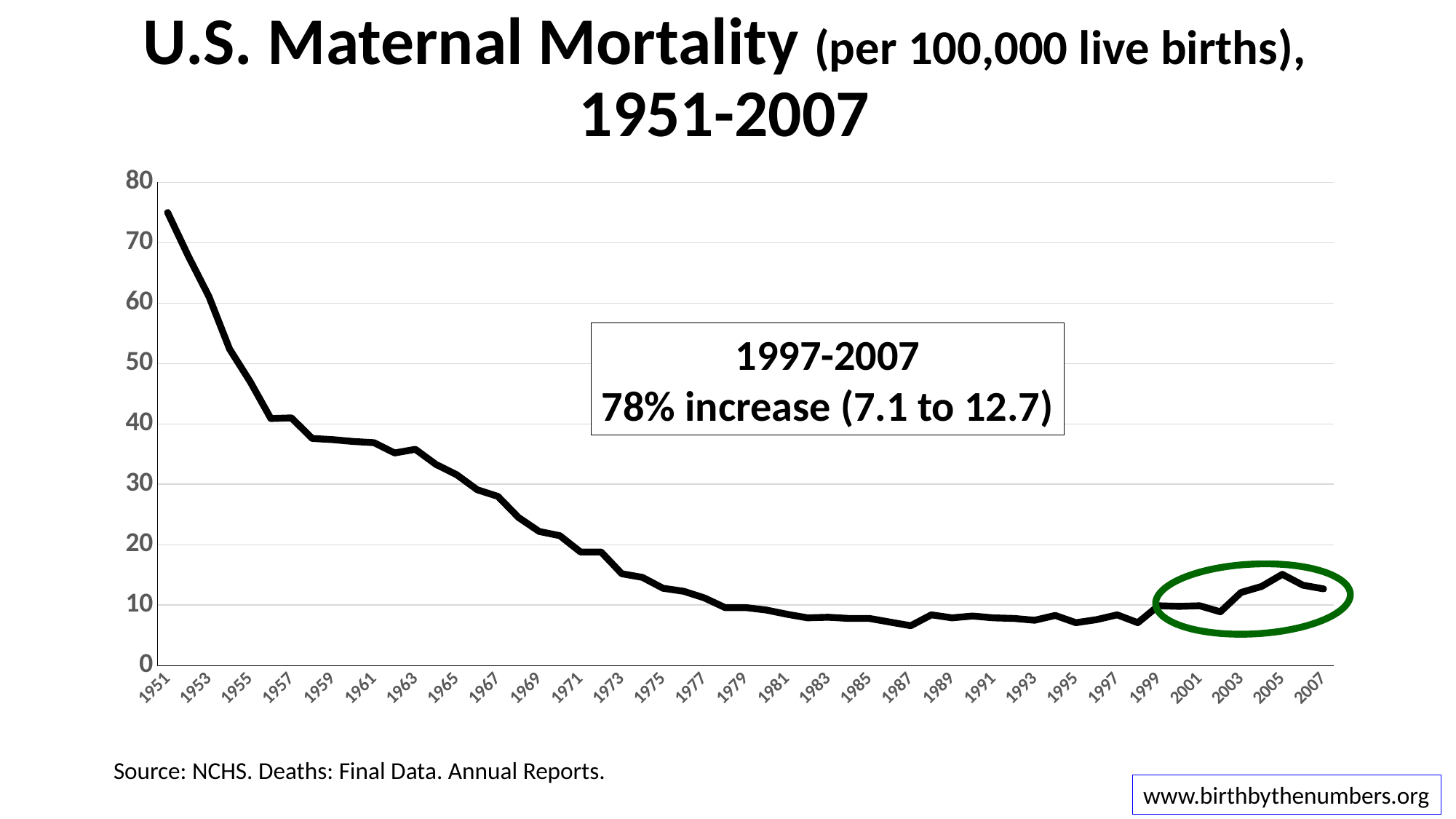
Which year has the highest maternal mortality rate on the chart? 1951 Is the maternal mortality rate in 1951 greater or less than 70? greater Which year has the higher maternal mortality rate, 1951 or 2007? 1951 According to the annotation box, what was the U.S. maternal mortality rate in 2007? 12.7 What kind of chart is shown on the slide? line chart What percentage increase in maternal mortality between 1997 and 2007 does the slide state? 78% Does the maternal mortality rate rise or fall between 1997 and 2007? rise By how much did the maternal mortality rate increase from 1997 (7.1) to 2007 (12.7)? 5.6 Is the maternal mortality rate in 1959 greater or less than 40? less According to the annotation box, what was the U.S. maternal mortality rate in 1997? 7.1 Is the maternal mortality rate in 2005 greater or less than 10? greater Does the maternal mortality rate rise or fall between 1951 and 1987? fall